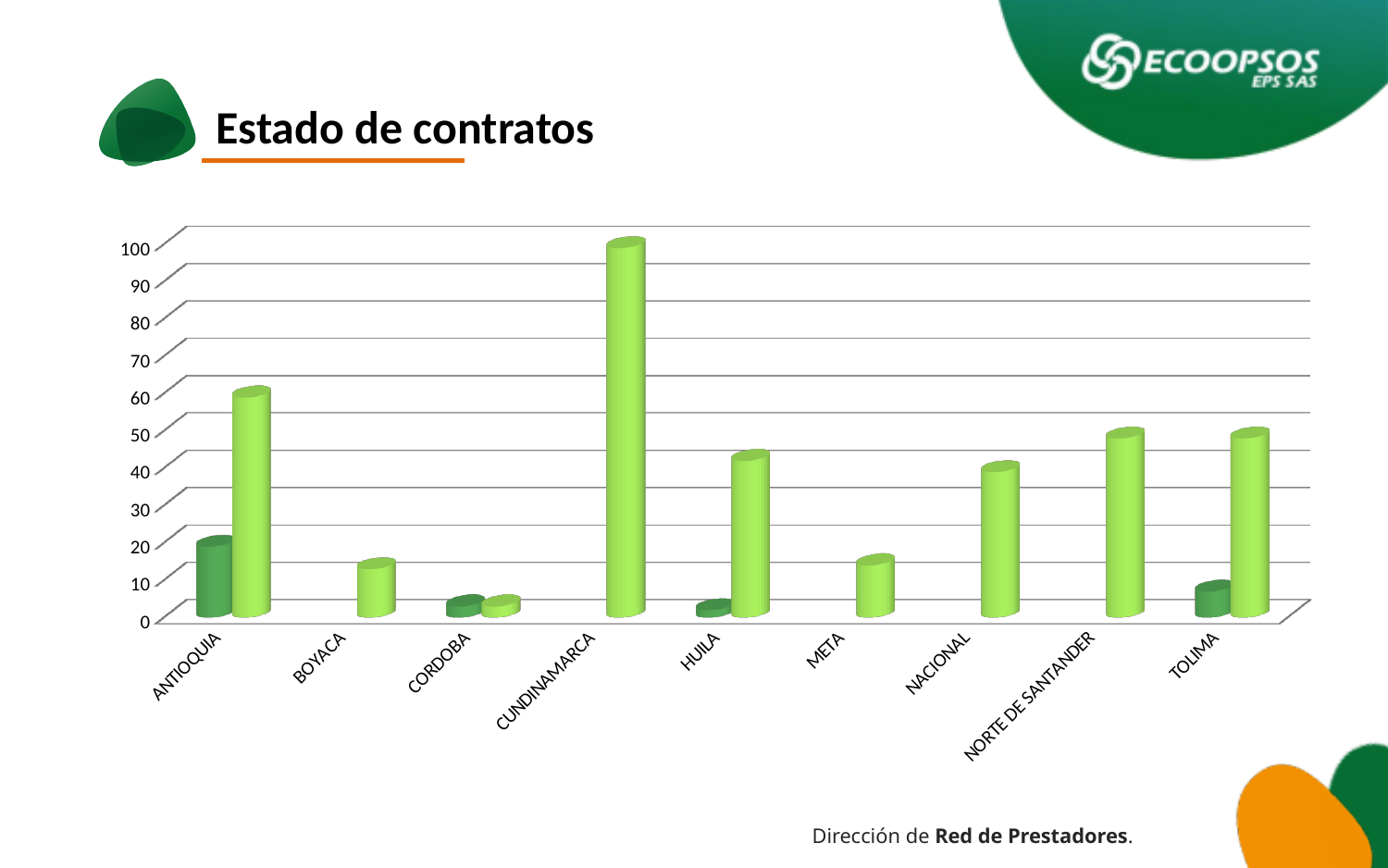
Which has the taller light green bar, CUNDINAMARCA or NORTE DE SANTANDER? CUNDINAMARCA Is the light green bar for ANTIOQUIA greater or less than 50? greater Is the light green bar for CUNDINAMARCA greater or less than 90? greater What is the title of the slide containing the chart? Estado de contratos Is the light green bar for BOYACA greater or less than 20? less How many categories are shown on the x axis of the chart? 9 Which has the taller light green bar, ANTIOQUIA or HUILA? ANTIOQUIA What kind of chart is shown on the slide? bar chart Which category has the tallest light green bar? CUNDINAMARCA Which category has the shortest light green bar? CORDOBA